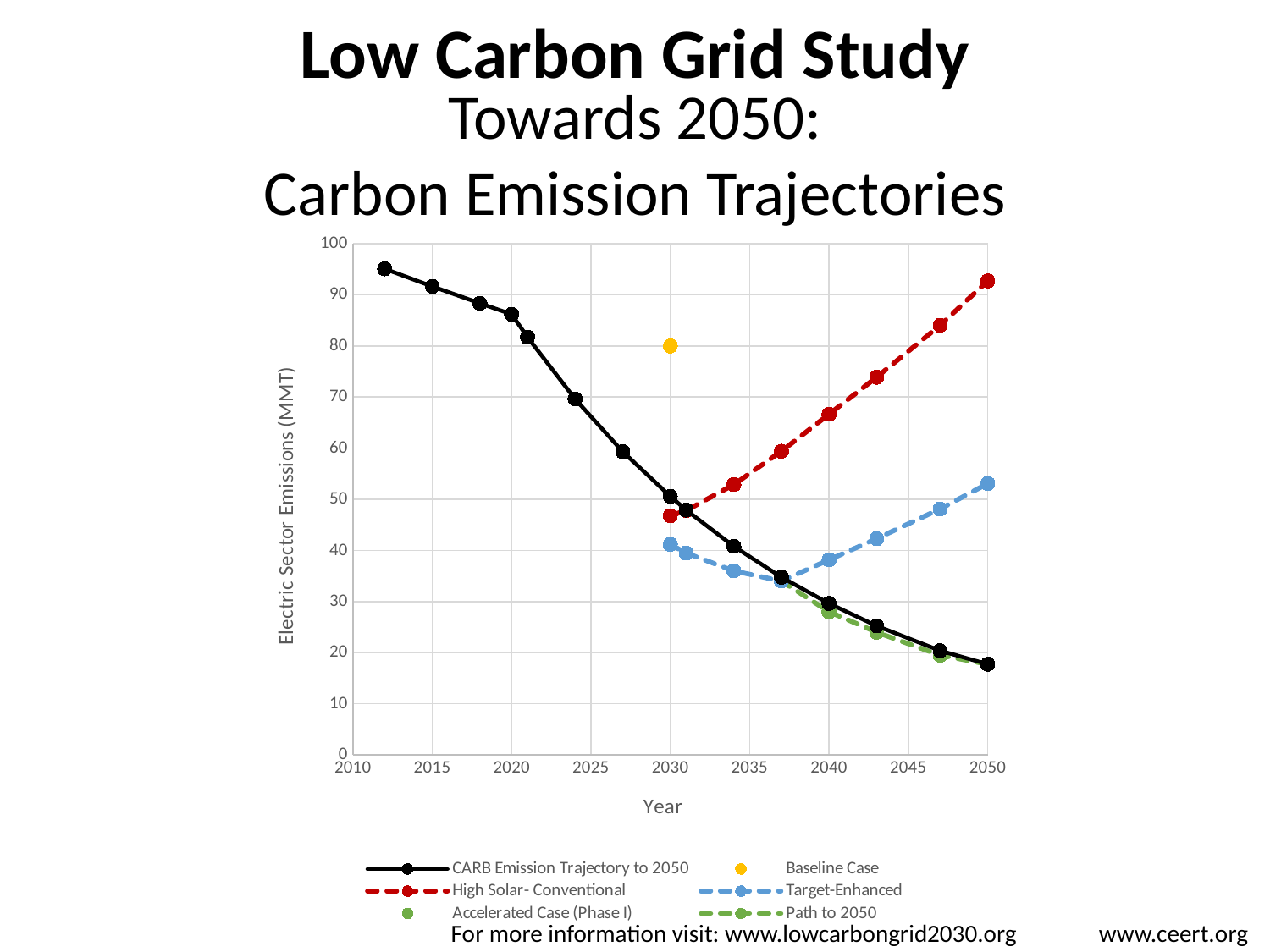
What is the label of the x axis? Year In 2050, which is higher: High Solar- Conventional or Target-Enhanced? High Solar- Conventional What is the label of the y axis? Electric Sector Emissions (MMT) What kind of chart is shown on the slide? Line chart Which series has the highest value in 2050? High Solar- Conventional How many series does the legend list? 6 Does the High Solar- Conventional series rise or fall from 2030 to 2050? Rise Is the value for CARB Emission Trajectory to 2050 in 2050 greater or less than 20? less Is the value for the Baseline Case in 2030 greater or less than 70? greater Is the value for Target-Enhanced in 2050 greater or less than 50? greater Does the CARB Emission Trajectory to 2050 series rise or fall from 2010 to 2050? Fall